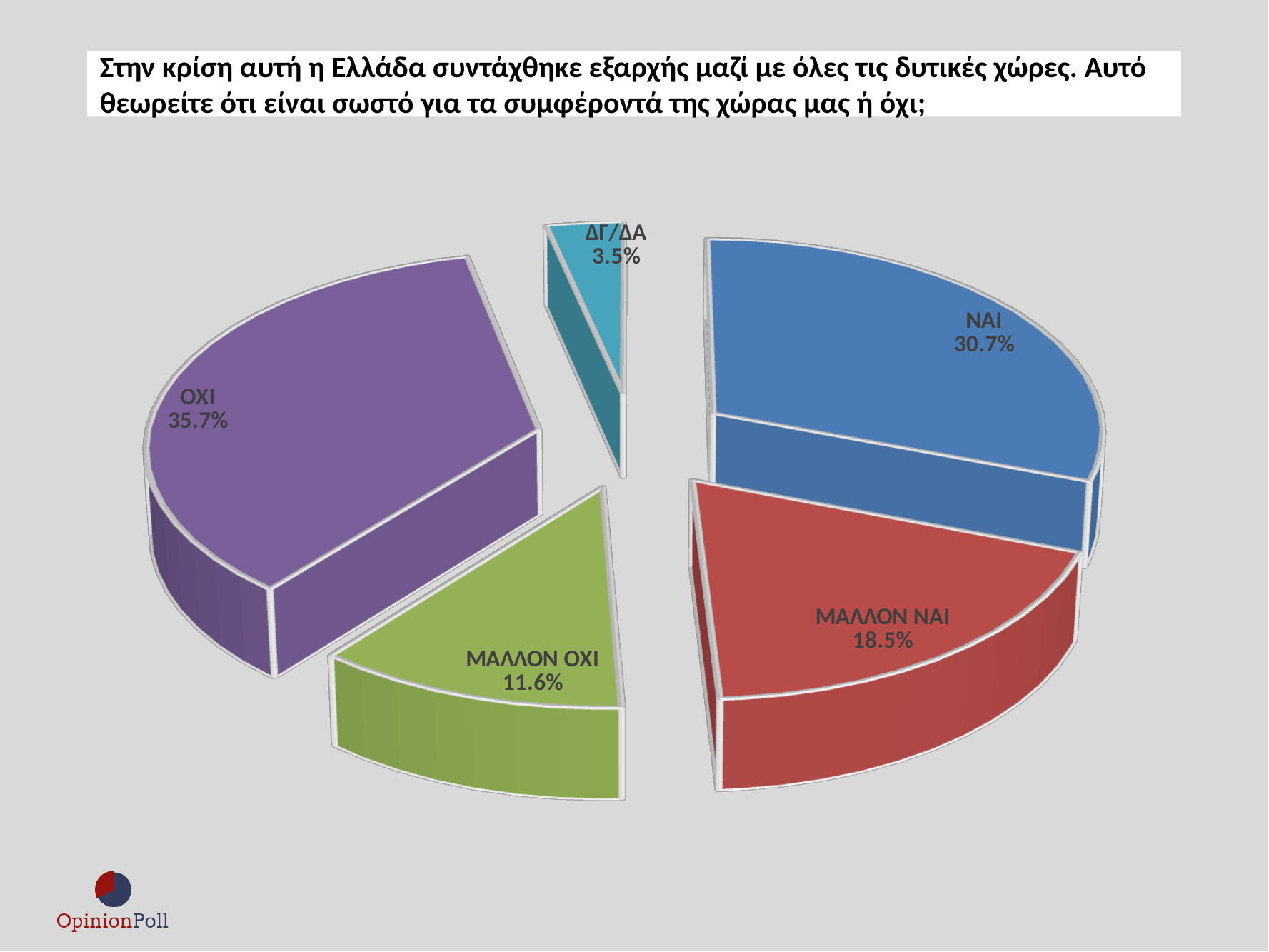
What colour is the ΟΧΙ slice? Purple What percentage of respondents answered ΝΑΙ? 30.7% What percentage of respondents answered ΔΓ/ΔΑ? 3.5% What percentage of respondents answered ΜΑΛΛΟΝ ΟΧΙ? 11.6% What is the difference in percentage points between ΟΧΙ and ΝΑΙ? 5 percentage points Which is larger, the share for ΜΑΛΛΟΝ ΝΑΙ or the share for ΜΑΛΛΟΝ ΟΧΙ? ΜΑΛΛΟΝ ΝΑΙ What kind of chart is shown on the slide? Pie chart Which response has the largest share of the pie? ΟΧΙ Which response has the smallest share of the pie? ΔΓ/ΔΑ What percentage of respondents answered ΜΑΛΛΟΝ ΝΑΙ? 18.5% What percentage of respondents answered ΟΧΙ? 35.7% How many slices does the pie chart have? 5